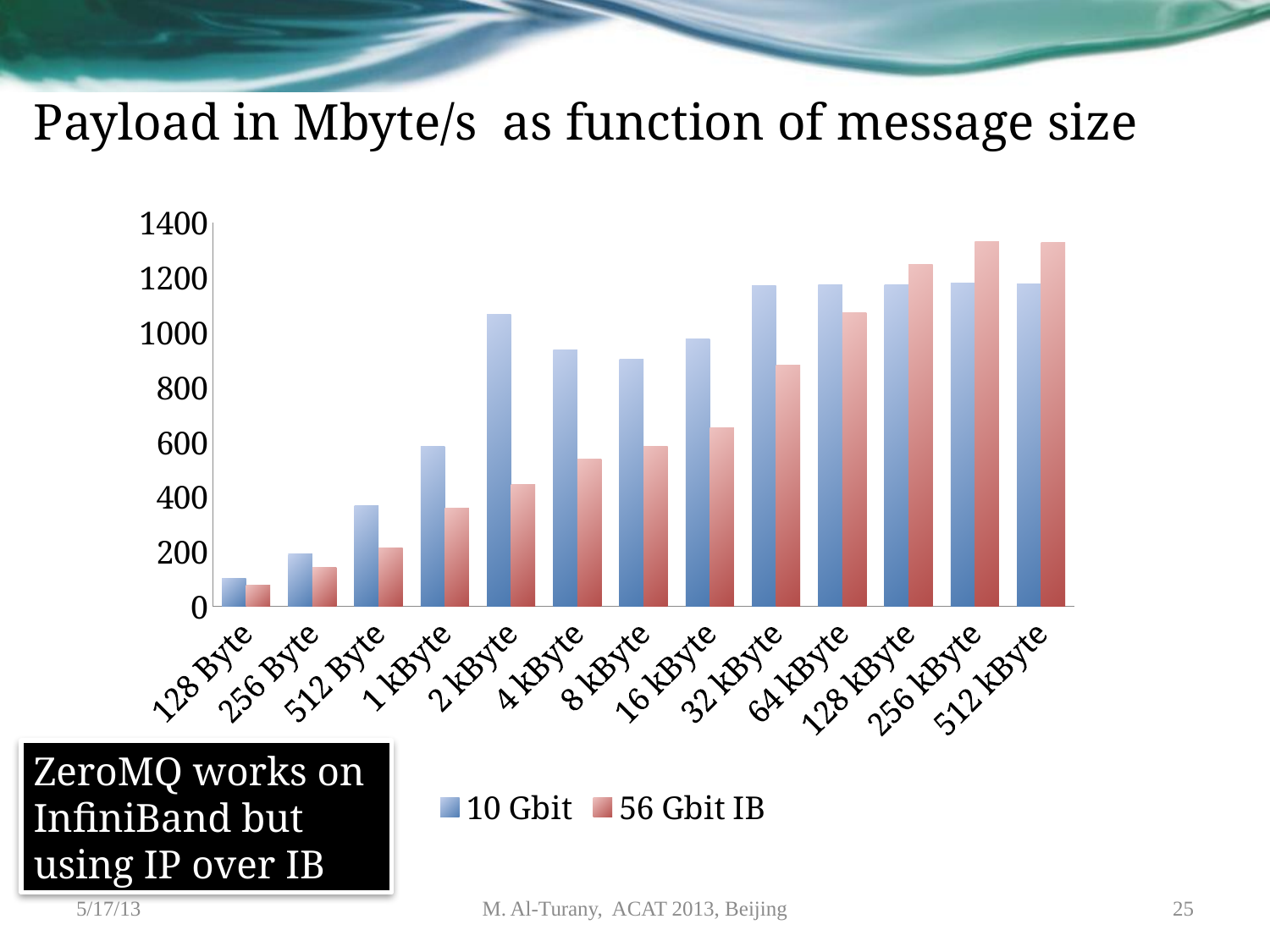
Is the 10 Gbit value for 2 kByte greater or less than 1000? greater How many message-size categories are shown on the x axis? 13 Is the 56 Gbit IB value for 2 kByte greater or less than 600? less Is the 56 Gbit IB value for 128 kByte greater or less than 1200? greater Which message size has the lowest value for the 10 Gbit series? 128 Byte How many series does the legend list? 2 Do the 56 Gbit IB values rise or fall as message size increases along the x axis? rise At 2 kByte, which series has the larger value, 10 Gbit or 56 Gbit IB? 10 Gbit What kind of chart is shown on the slide? bar chart Which message size has the lowest value for the 56 Gbit IB series? 128 Byte At 256 kByte, which series has the larger value, 10 Gbit or 56 Gbit IB? 56 Gbit IB